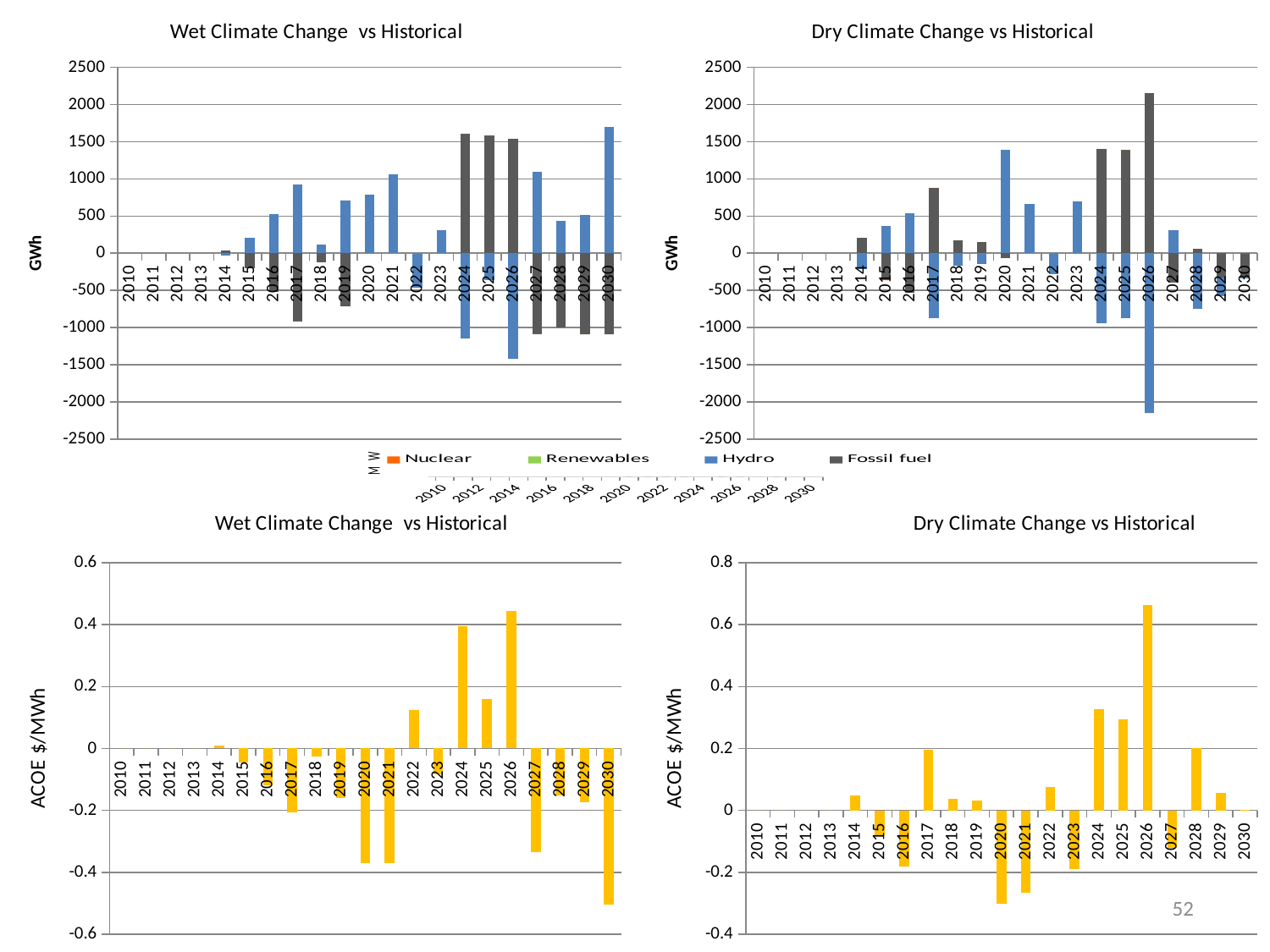
In the top-left chart (Wet Climate Change vs Historical, GWh), which is larger, the Hydro value for 2020 or for 2021? 2021 In the top-right chart (Dry Climate Change vs Historical, GWh), is the Hydro value for 2026 greater or less than -2000? less In the bottom-left chart (Wet Climate Change vs Historical, ACOE $/MWh), which year has the lowest value? 2030 In the top-left chart (Wet Climate Change vs Historical, GWh), is the Fossil fuel value for 2024 greater or less than 1500? greater In the bottom-left chart (Wet Climate Change vs Historical, ACOE $/MWh), which year has the highest value? 2026 How many series does the legend between the top charts list? 4 In the bottom-right chart (Dry Climate Change vs Historical, ACOE $/MWh), which year has the highest value? 2026 What kind of chart is the top-left chart (Wet Climate Change vs Historical, GWh)? bar chart In the top-right chart (Dry Climate Change vs Historical, GWh), is the Fossil fuel value for 2026 greater or less than 2000? greater How many years are shown on the x axis of the bottom-left chart (Wet Climate Change vs Historical, ACOE $/MWh)? 21